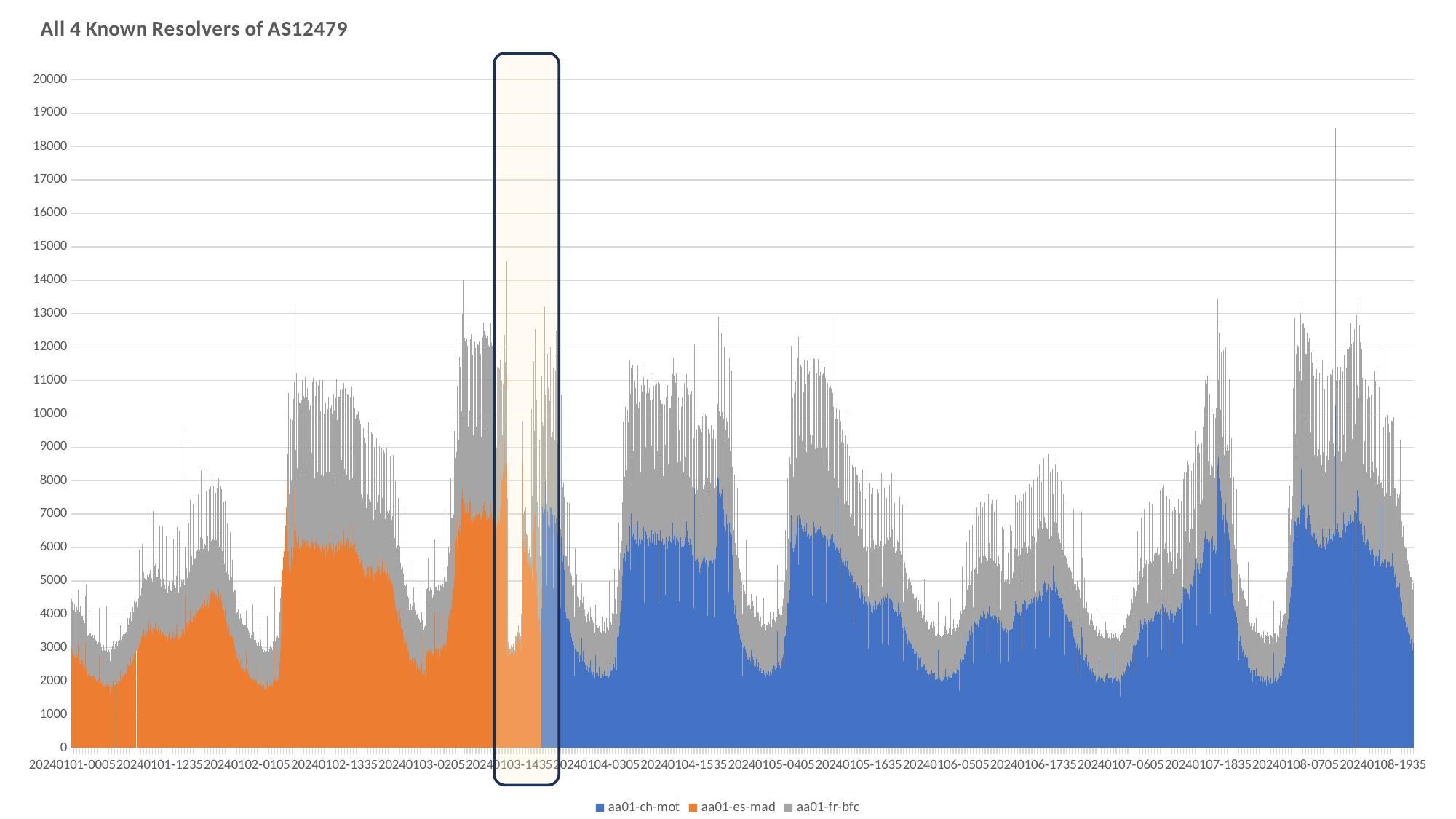
What kind of chart is shown on the slide? stacked area chart What is the title of the chart? All 4 Known Resolvers of AS12479 Which series forms the bottom of the stack in the right part of the chart, after the highlighted region? aa01-ch-mot How many series does the legend list? 3 Which series is shown in gray in the legend? aa01-fr-bfc Is the highest peak of the stacked total, near 20240108-0705, greater or less than 15000? greater Is the stacked total at the dip near 20240104-0305 greater or less than 5000? less Is the stacked total at the peak near 20240102-1335 greater or less than 9000? greater